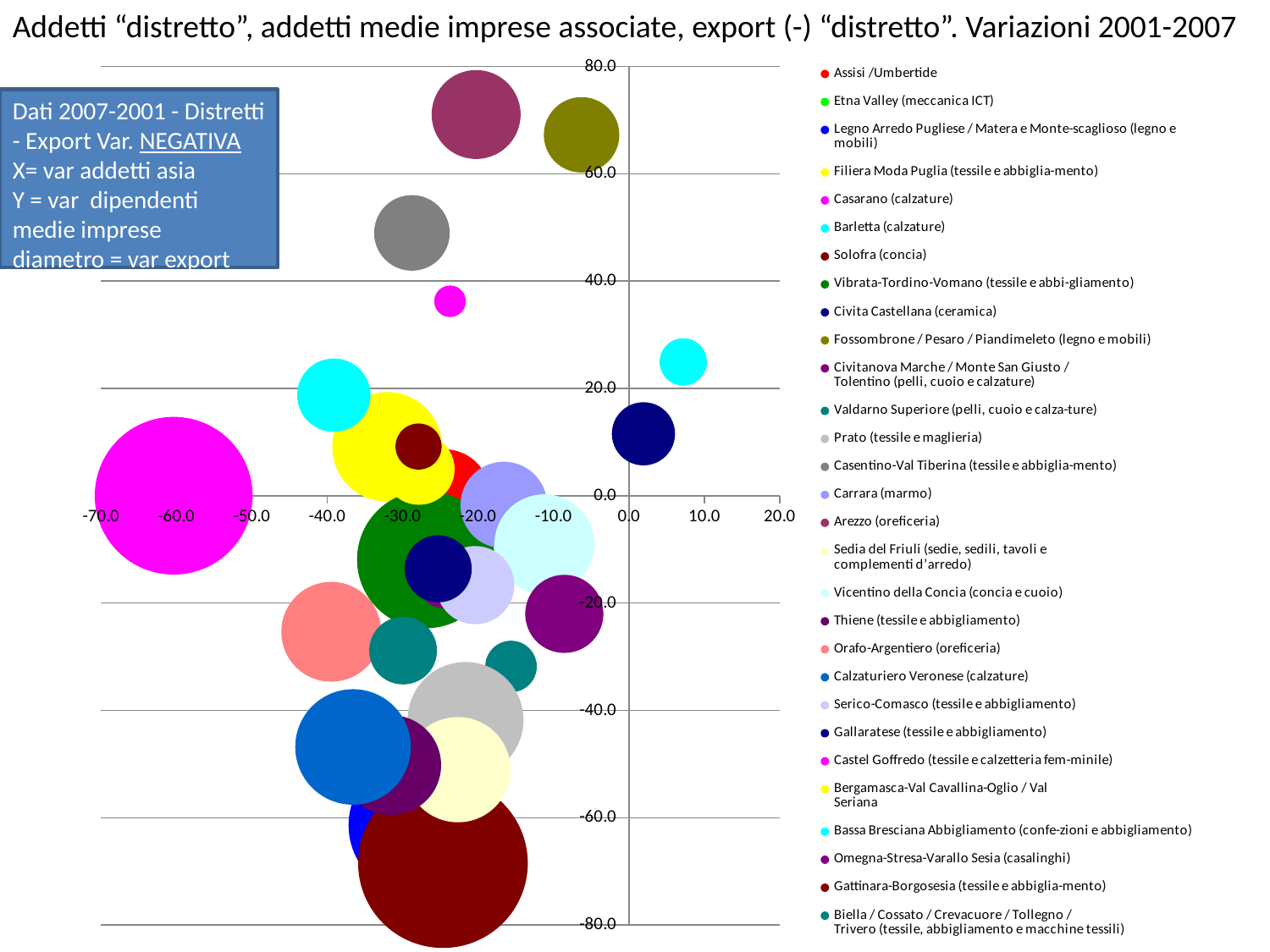
Is the y value for Vibrata-Tordino-Vomano (tessile e abbigliamento) greater or less than 0.0? less What is the title of the chart? Addetti "distretto", addetti medie imprese associate, export (-) "distretto". Variazioni 2001-2007 Is the y value for Fossombrone / Pesaro / Piandimeleto (legno e mobili) greater or less than 60.0? greater How many series does the legend list? 29 Is the y value for Casentino-Val Tiberina (tessile e abbigliamento) greater or less than 40.0? greater What kind of chart is shown on the slide? Bubble chart According to the text box, what does the diameter of each bubble represent? var export